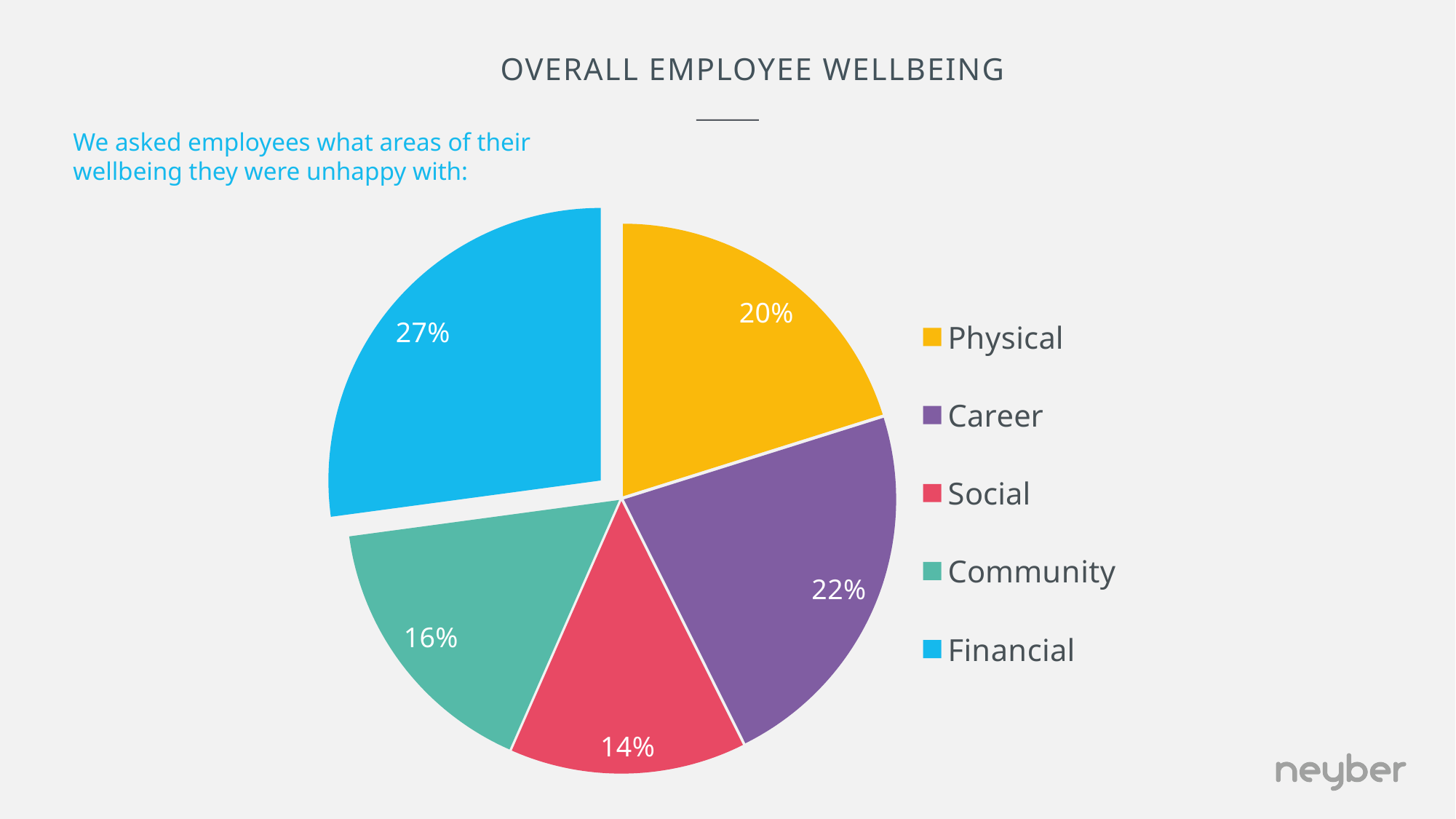
Which is larger, Career or Physical? Career What percentage of the pie is Financial? 27% What percentage of the pie is Career? 22% What is the difference in percentage points between Financial and Social? 13 What is the title of the chart? OVERALL EMPLOYEE WELLBEING What percentage of the pie is Physical? 20% Which category has the smallest slice of the pie? Social How many categories does the pie chart have? 5 What percentage of the pie is Community? 16% Which category has the largest slice of the pie? Financial What percentage of the pie is Social? 14% What kind of chart is shown on the slide? Pie chart